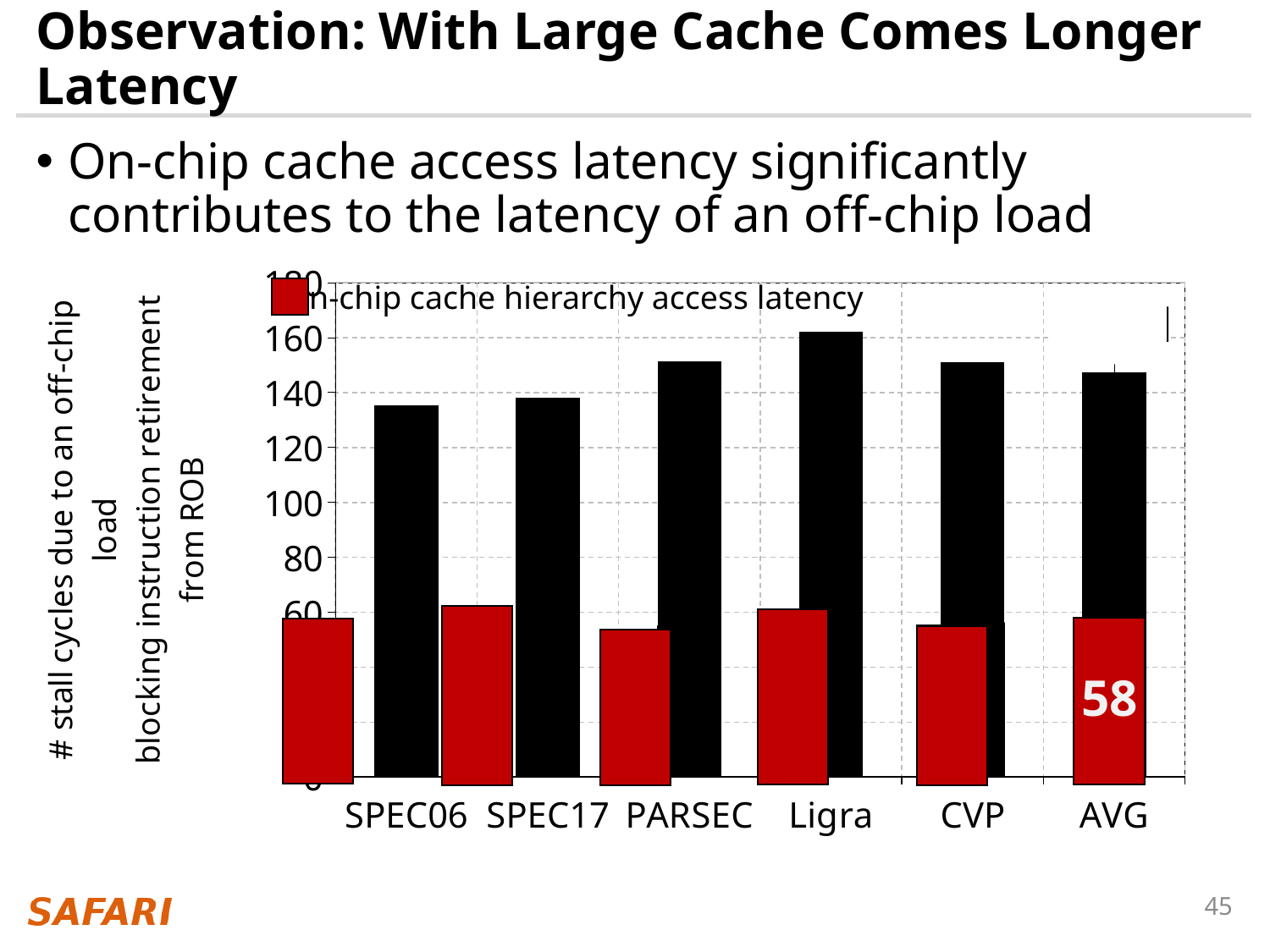
What kind of chart is shown on the slide? bar chart Which is larger, the black bar for Ligra or the black bar for SPEC06? Ligra Is the black bar for SPEC06 greater or less than 140? less Is the black bar for Ligra greater or less than 140? greater Is the red bar for PARSEC greater or less than 60? less Which is larger, the black bar for PARSEC or the black bar for SPEC17? PARSEC How many categories are shown on the x axis? 6 What is the last category on the x axis? AVG What value is labelled on the red bar for AVG? 58 Which category has the tallest black bar? Ligra Which colour represents on-chip cache hierarchy access latency in the legend? red